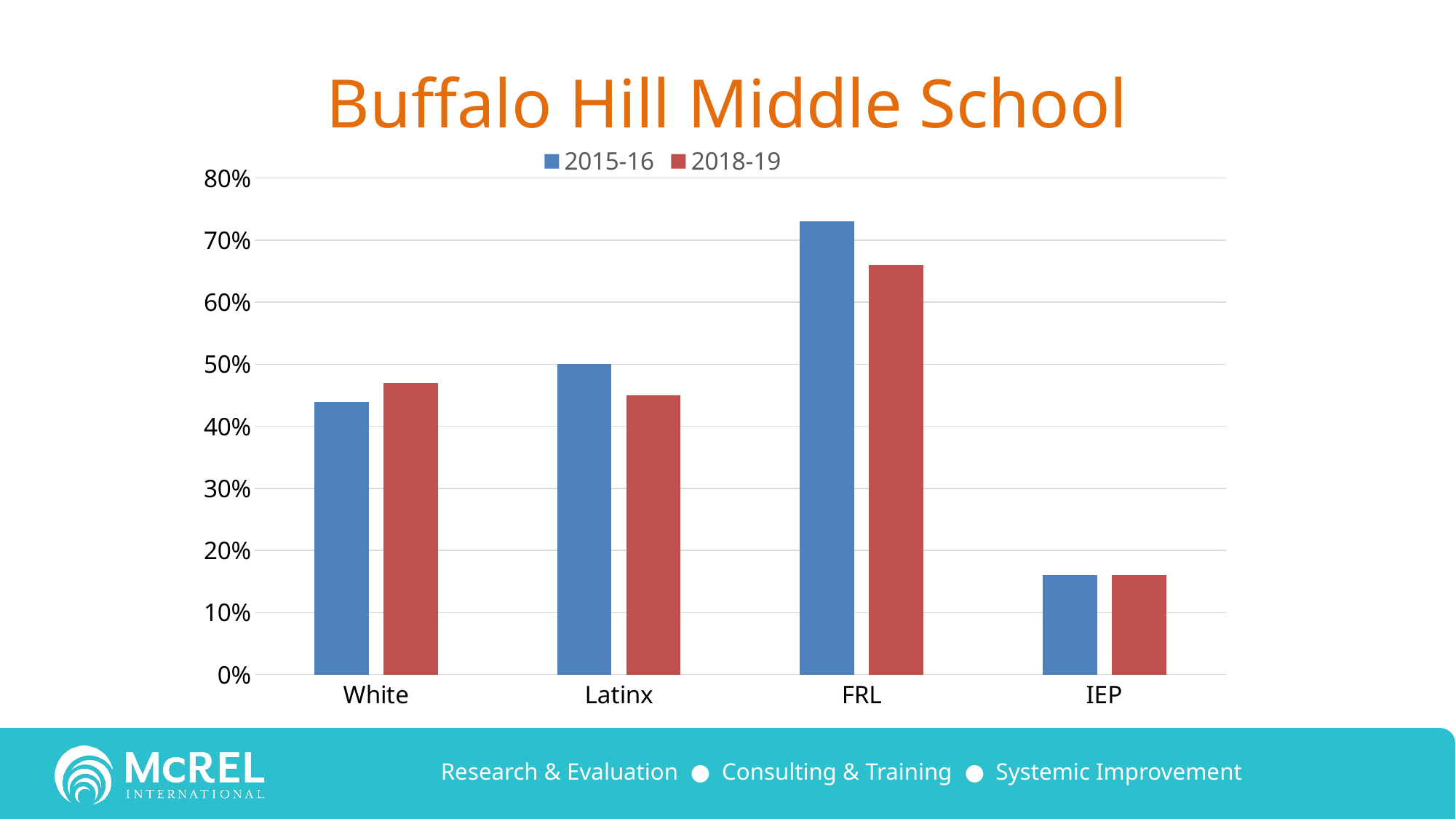
Which category has the lowest value for 2018-19? IEP What kind of chart is shown on the slide? bar chart Is the value for Latinx in 2018-19 greater or less than 50%? less Which category has the highest value for 2015-16? FRL Is the value for FRL in 2015-16 greater or less than 70%? greater For FRL, which series has the larger value, 2015-16 or 2018-19? 2015-16 What is the title of the chart? Buffalo Hill Middle School Is the value for IEP in 2015-16 greater or less than 20%? less How many series does the legend list? 2 Which colour represents the 2018-19 series in the legend? red For White, which series has the larger value, 2015-16 or 2018-19? 2018-19 How many categories are shown on the x axis? 4